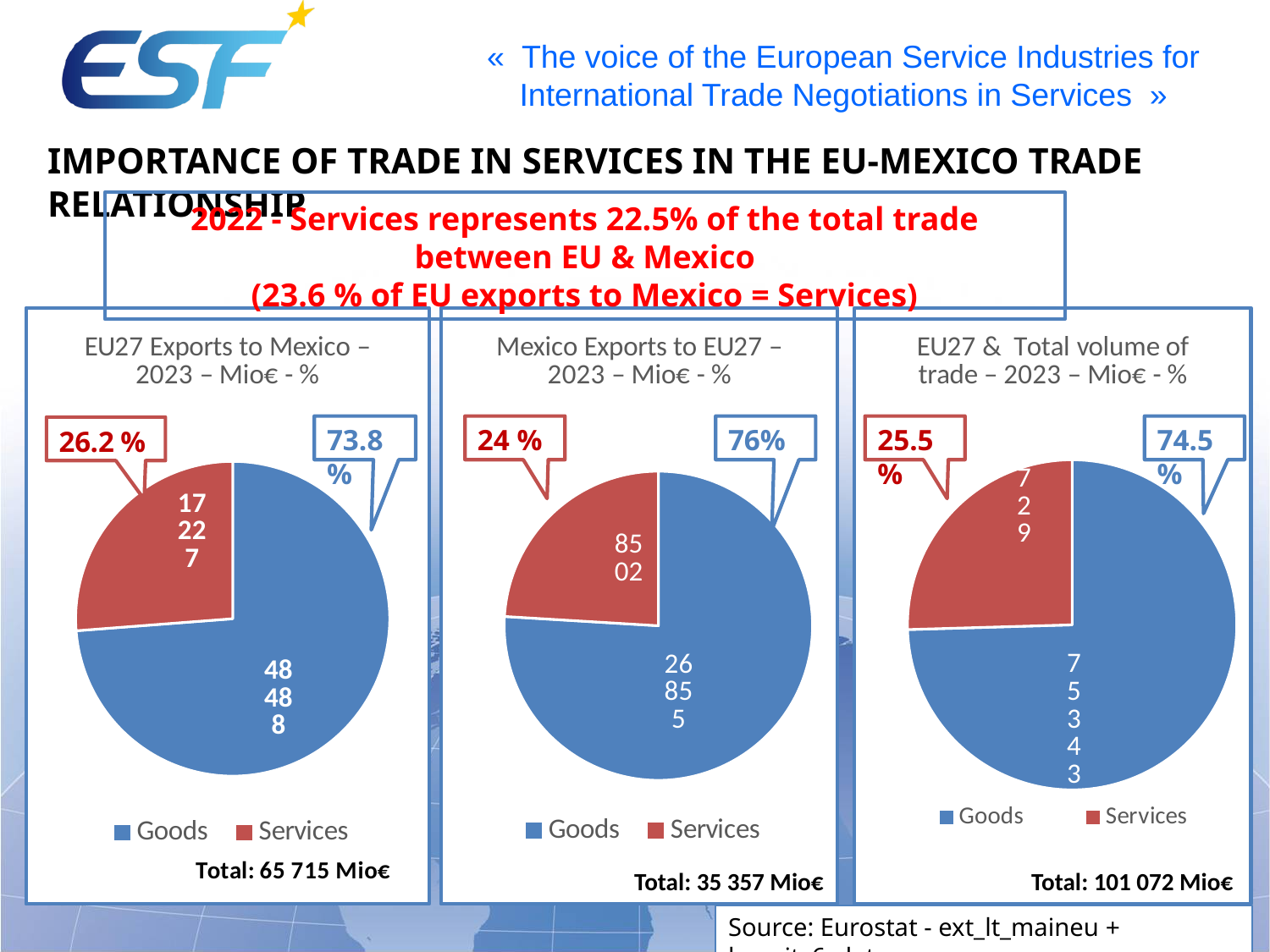
What kind of charts are shown on the slide? Pie charts In the 'EU27 Exports to Mexico – 2023' chart, what share of the pie is Goods? 73.8 % In the 'Mexico Exports to EU27 – 2023' chart, what share of the pie is Services? 24 % In the 'EU27 Exports to Mexico – 2023' chart, what share of the pie is Services? 26.2 % In the 'EU27 & Total volume of trade – 2023' chart, what is the total shown below the pie? 101 072 Mio€ In the 'Mexico Exports to EU27 – 2023' chart, what is the total shown below the pie? 35 357 Mio€ In the 'EU27 Exports to Mexico – 2023' chart, what is the total shown below the pie? 65 715 Mio€ In the 'Mexico Exports to EU27 – 2023' chart, which slice is larger, Goods or Services? Goods In the 'EU27 Exports to Mexico – 2023' chart, which colour represents Services? Red How many entries does the legend of the 'EU27 & Total volume of trade – 2023' chart list? 2